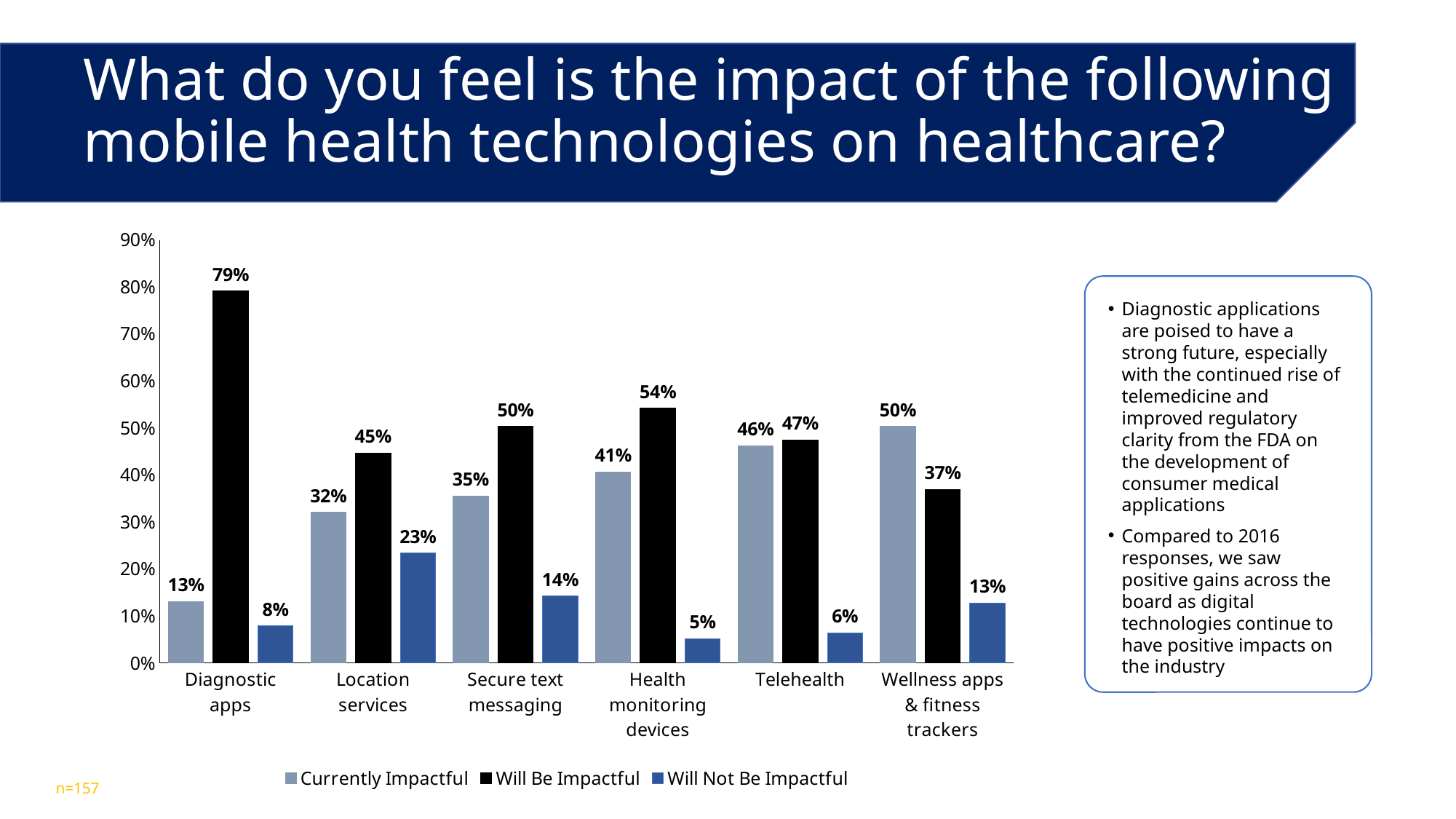
What is the difference between the 'Will Be Impactful' and 'Currently Impactful' values for Diagnostic apps? 66% Which category has the highest 'Will Be Impactful' value? Diagnostic apps Which is larger for Wellness apps & fitness trackers: 'Currently Impactful' or 'Will Be Impactful'? Currently Impactful How many mobile health technology categories are shown on the x axis? 6 What is the 'Will Not Be Impactful' value for Location services? 23% How many series does the legend list? 3 What is the 'Currently Impactful' value for Secure text messaging? 35% What is the 'Currently Impactful' value for Telehealth? 46% What is the 'Will Be Impactful' value for Diagnostic apps? 79% What colour are the 'Will Be Impactful' bars? Black What kind of chart is shown on the slide? Bar chart Which category has the lowest 'Will Not Be Impactful' value? Health monitoring devices